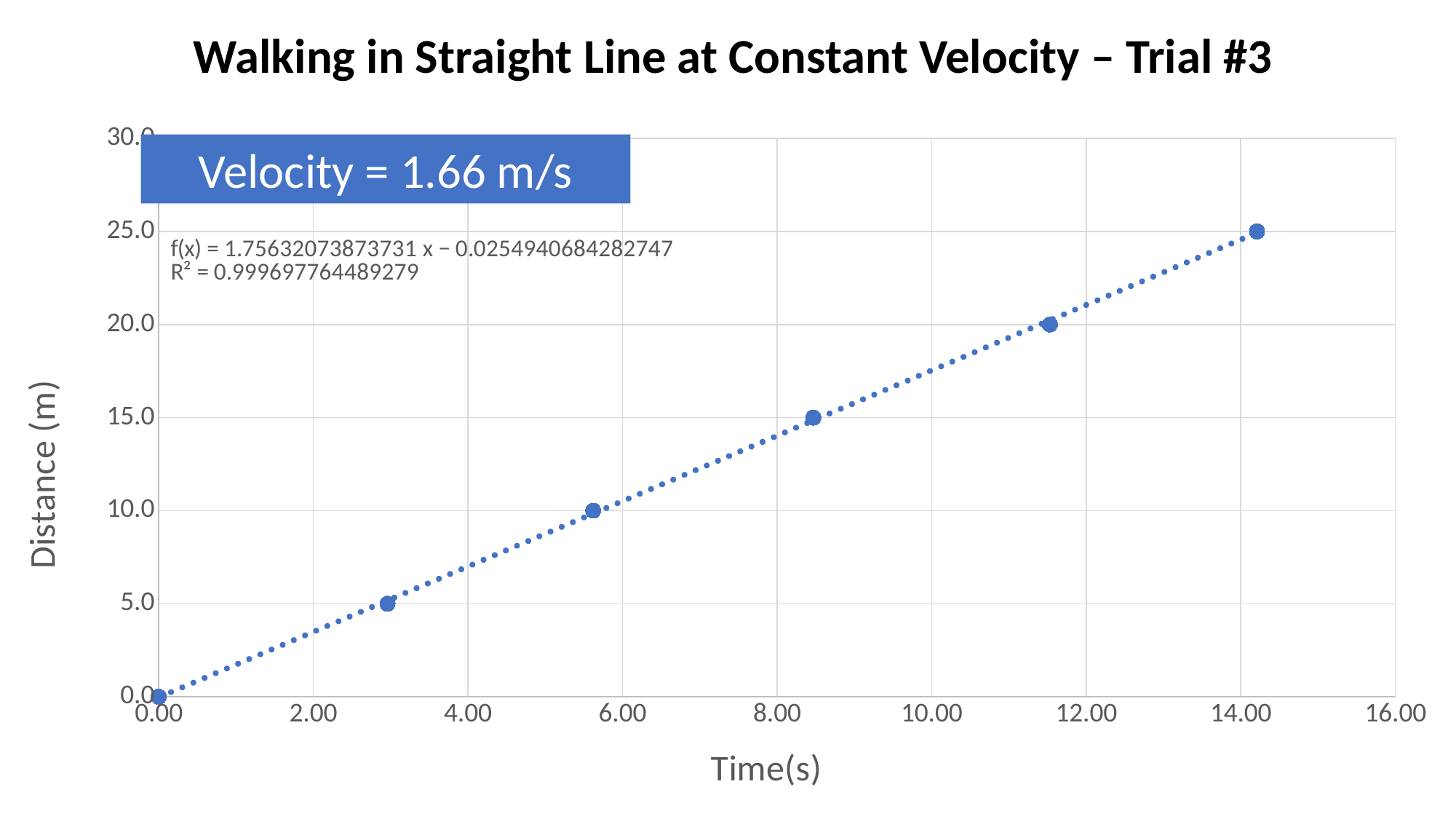
What is the highest distance value reached by a plotted point? 25.0 How many data points are plotted on the chart? 6 What is the lowest distance value among the plotted points? 0.0 Is the time value of the point at 15.0 m greater or less than 8.00? greater What velocity is stated in the blue box on the chart? 1.66 m/s Is the time value of the point at 20.0 m greater or less than 10.00? greater Do the distance values rise or fall as time increases along the x axis? Rise What is the distance value of the point plotted at time 0.00 s? 0.0 What kind of chart is shown on the slide? Scatter chart What is the title of the chart? Walking in Straight Line at Constant Velocity – Trial #3 Is the time value of the point at 5.0 m greater or less than 4.00? less